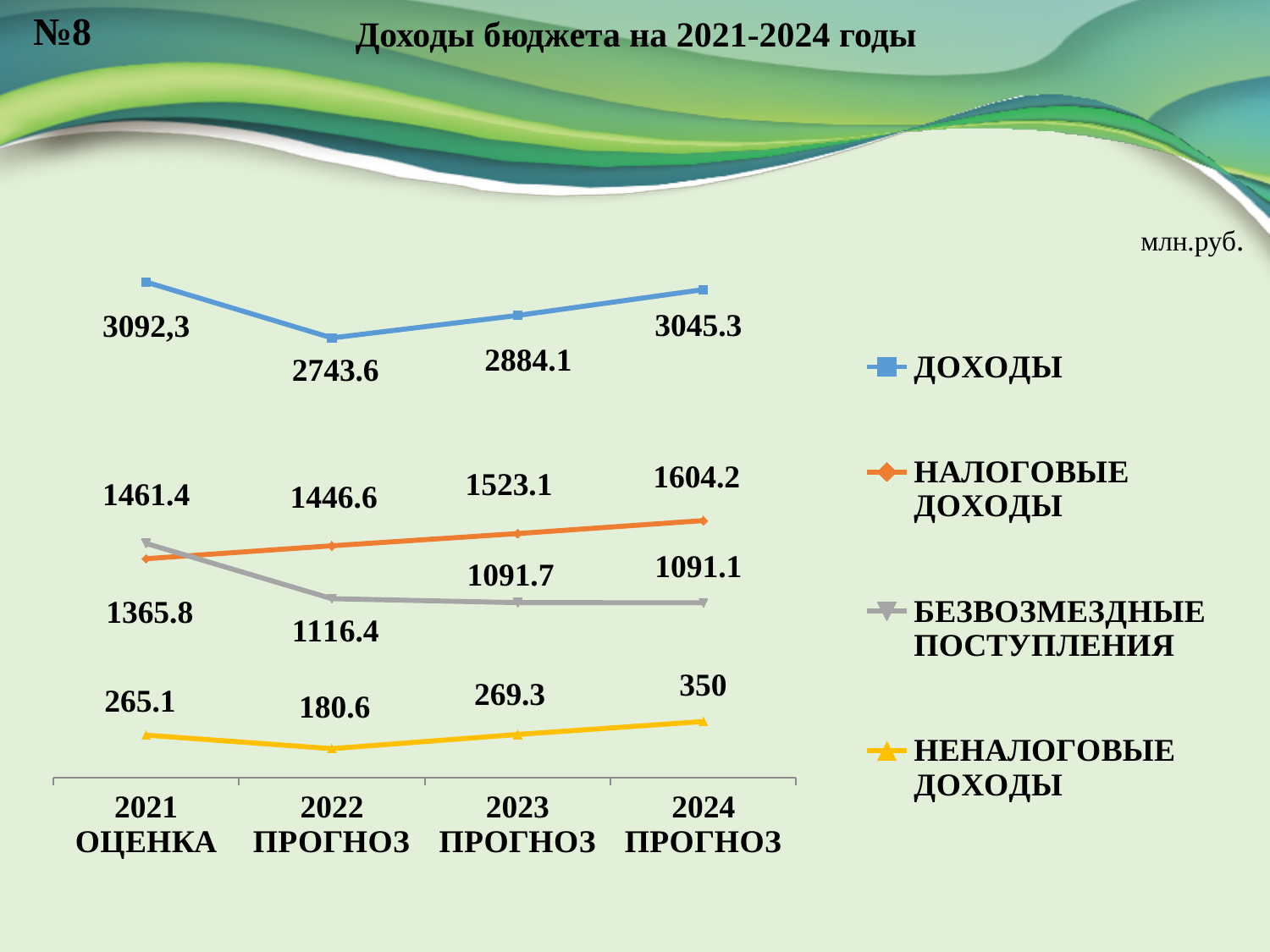
What is the difference between НЕНАЛОГОВЫЕ ДОХОДЫ in 2024 ПРОГНОЗ and in 2022 ПРОГНОЗ? 169.4 What is the value of НАЛОГОВЫЕ ДОХОДЫ for 2024 ПРОГНОЗ? 1604.2 What is the value of ДОХОДЫ for 2022 ПРОГНОЗ? 2743.6 How many series does the legend list? 4 In which year is the value of НЕНАЛОГОВЫЕ ДОХОДЫ highest? 2024 ПРОГНОЗ What kind of chart is shown on the slide? Line chart What is the value of НЕНАЛОГОВЫЕ ДОХОДЫ for 2023 ПРОГНОЗ? 269.3 Do the values of НАЛОГОВЫЕ ДОХОДЫ rise or fall from 2021 to 2024? Rise What is the value of БЕЗВОЗМЕЗДНЫЕ ПОСТУПЛЕНИЯ for 2021 ОЦЕНКА? 1461.4 What is the difference between НАЛОГОВЫЕ ДОХОДЫ in 2024 ПРОГНОЗ and in 2021 ОЦЕНКА? 238.4 In which year is the value of ДОХОДЫ lowest? 2022 ПРОГНОЗ Which is larger in 2021 ОЦЕНКА: НАЛОГОВЫЕ ДОХОДЫ or БЕЗВОЗМЕЗДНЫЕ ПОСТУПЛЕНИЯ? БЕЗВОЗМЕЗДНЫЕ ПОСТУПЛЕНИЯ